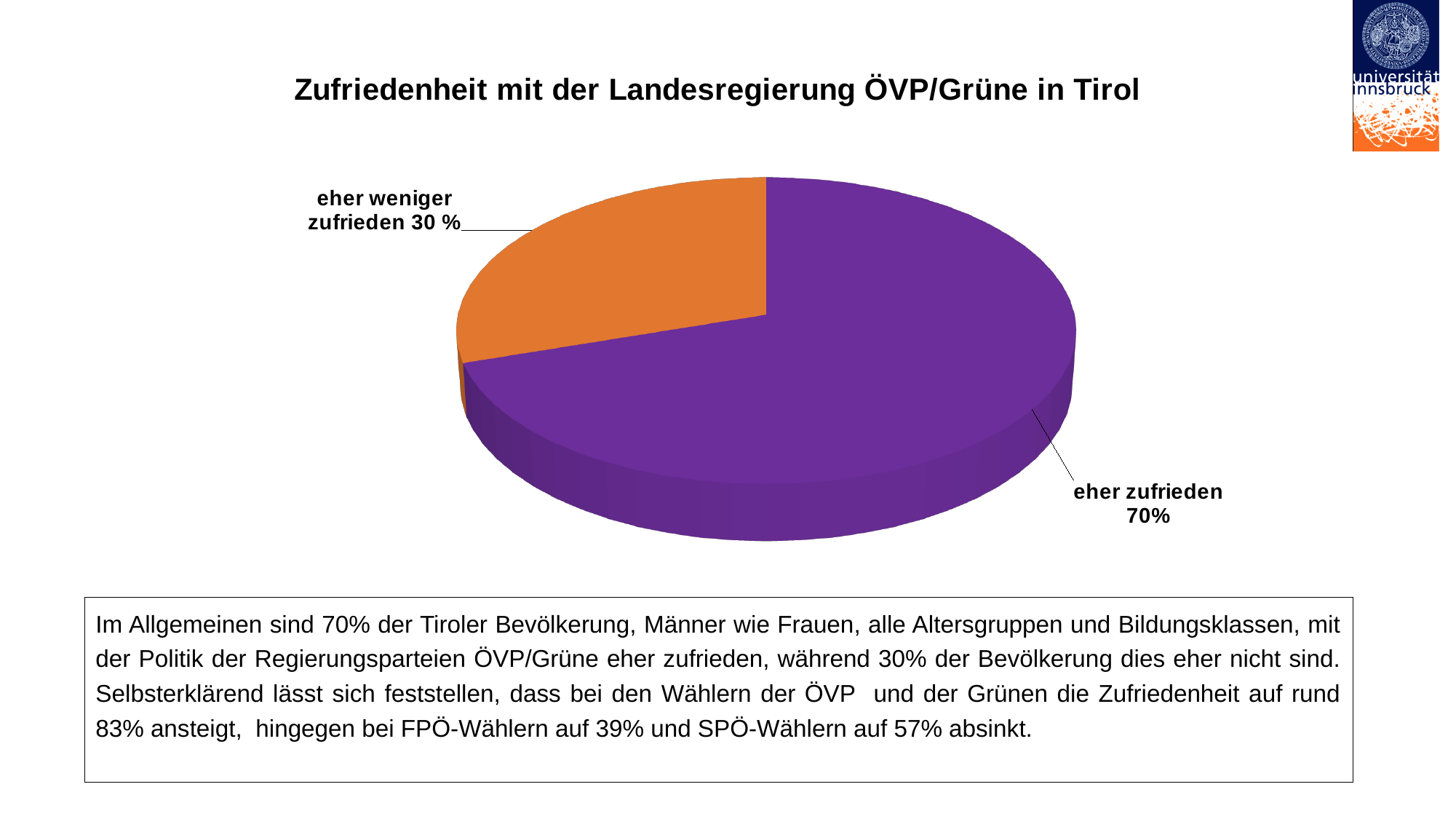
What is the title of the chart? Zufriedenheit mit der Landesregierung ÖVP/Grüne in Tirol What share of the pie is labelled "eher weniger zufrieden"? 30 % What share of the pie is labelled "eher zufrieden"? 70% Which slice is larger, "eher zufrieden" or "eher weniger zufrieden"? eher zufrieden How many slices does the pie chart have? 2 Which slice of the pie is the largest? eher zufrieden What colour is the "eher zufrieden" slice? purple What is the difference in percentage points between the "eher zufrieden" and "eher weniger zufrieden" slices? 40 Which slice of the pie is the smallest? eher weniger zufrieden What kind of chart is shown on the slide? pie chart